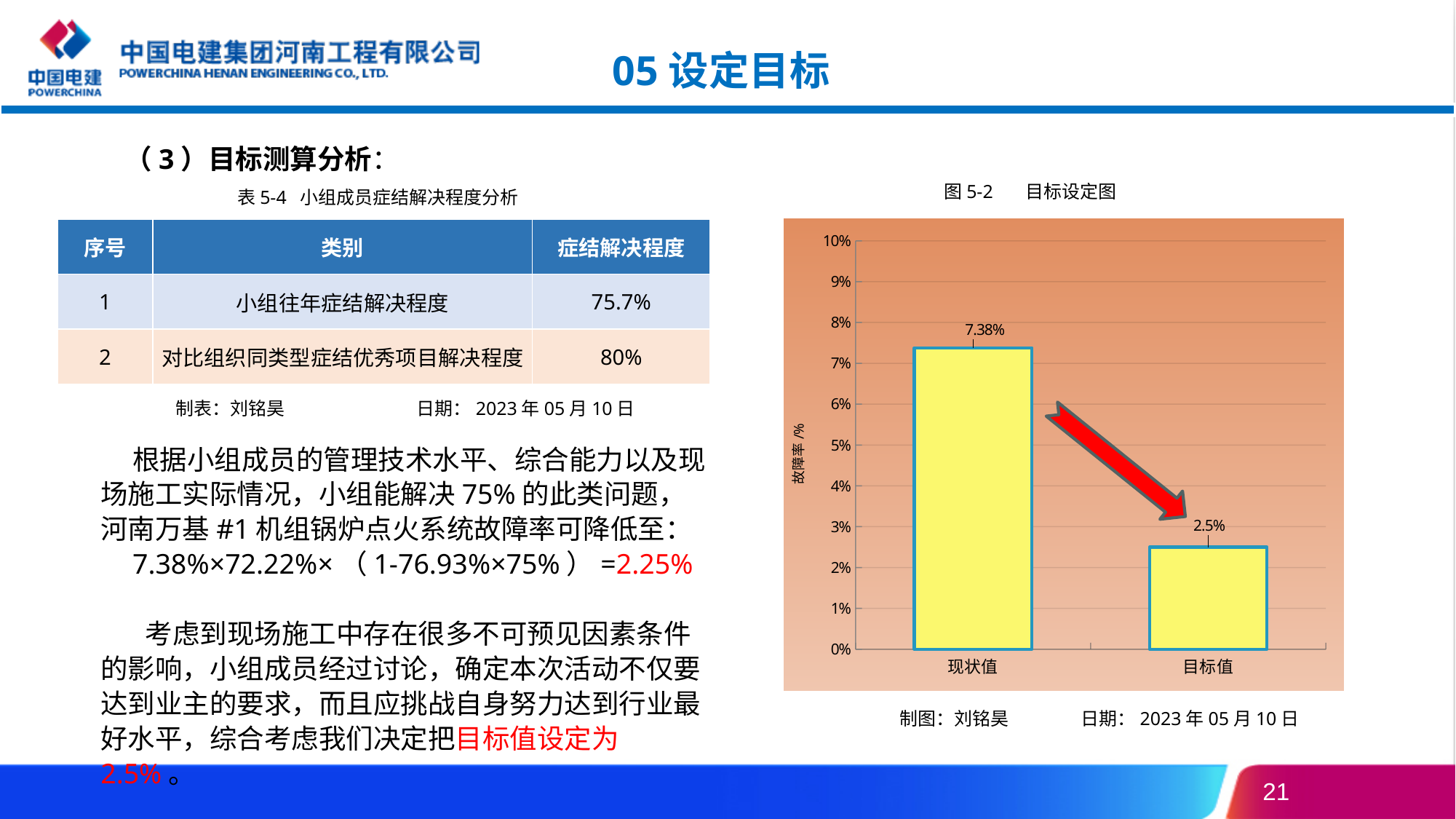
What is the difference between the 现状值 and 目标值 values in the chart? 4.88% Which category has the lowest value in the chart? 目标值 What kind of chart is shown on the slide? bar chart Which category has the highest value in the chart? 现状值 Which is larger in the chart, 现状值 or 目标值? 现状值 Is the value for 目标值 greater or less than 3%? less Is the value for 现状值 greater or less than 5%? greater How many categories are plotted in the chart? 2 What is the title of the chart on the slide? 图 5-2 目标设定图 What is the value for 现状值 in the chart? 7.38% Do the values rise or fall from 现状值 to 目标值 along the x axis? fall What is the value for 目标值 in the chart? 2.5%